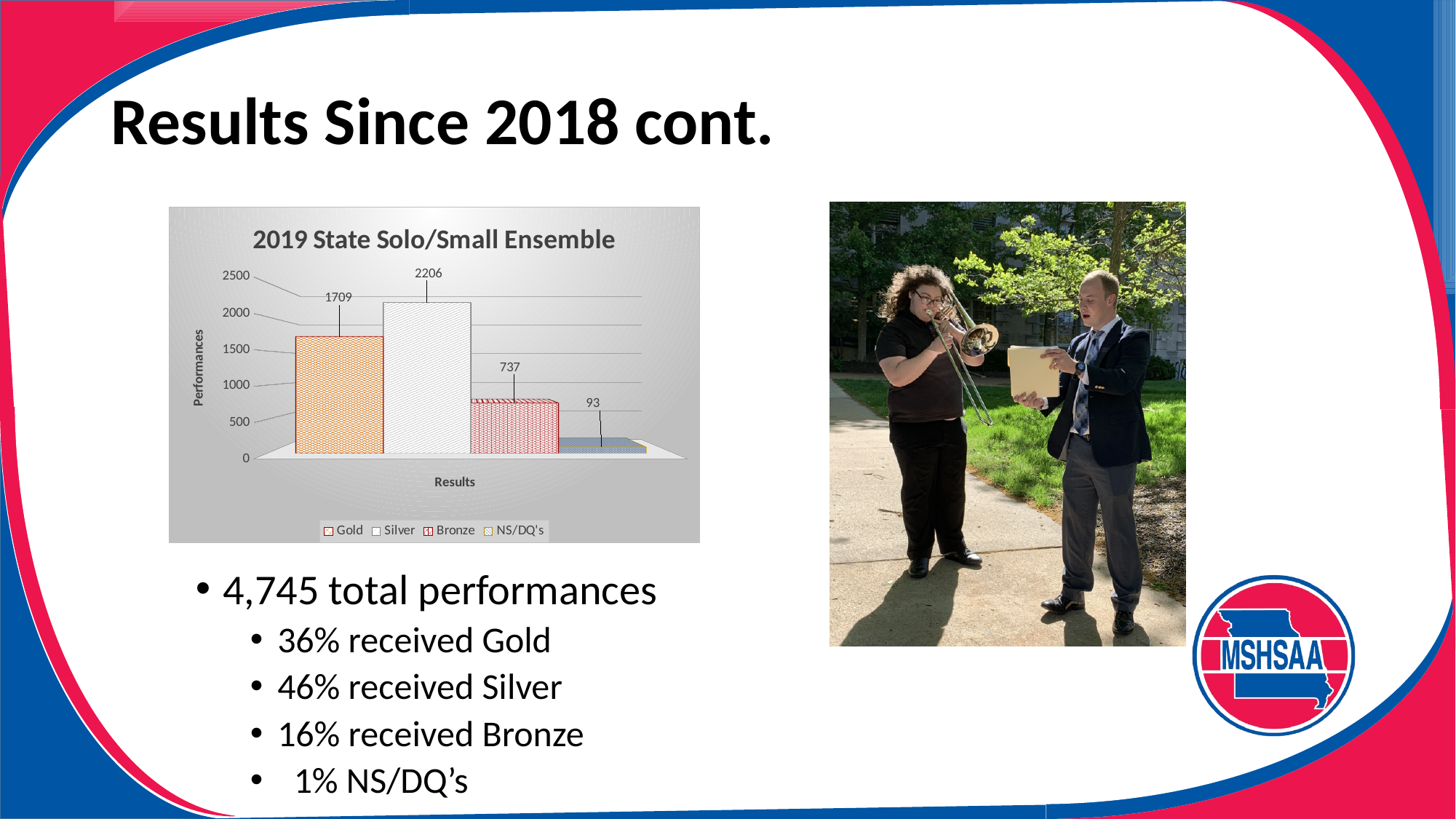
Which is larger in the 2019 State Solo/Small Ensemble chart, Gold or Bronze? Gold Which category has the lowest value in the 2019 State Solo/Small Ensemble chart? NS/DQ's What is the value for NS/DQ's in the 2019 State Solo/Small Ensemble chart? 93 What kind of chart is the 2019 State Solo/Small Ensemble chart? bar chart What is the difference between the Silver and Gold values in the 2019 State Solo/Small Ensemble chart? 497 What is the value for Silver in the 2019 State Solo/Small Ensemble chart? 2206 Which category has the highest value in the 2019 State Solo/Small Ensemble chart? Silver What is the value for Bronze in the 2019 State Solo/Small Ensemble chart? 737 Is the value for Bronze in the 2019 State Solo/Small Ensemble chart greater or less than 1000? less What is the y-axis label of the 2019 State Solo/Small Ensemble chart? Performances What is the value for Gold in the 2019 State Solo/Small Ensemble chart? 1709 How many series does the legend of the 2019 State Solo/Small Ensemble chart list? 4